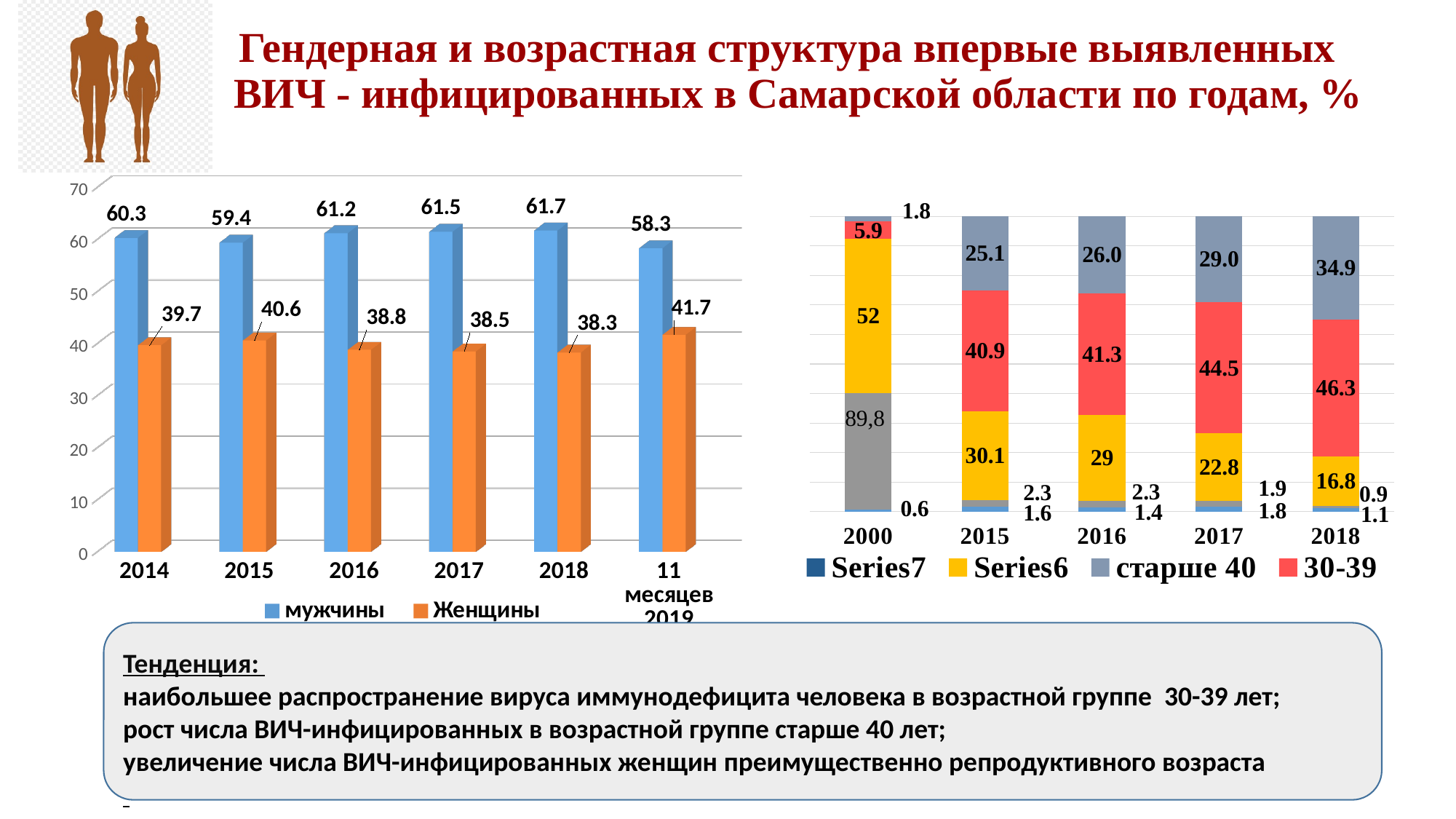
On the right chart, does the value for the 30-39 group rise or fall from 2015 to 2018? rise On the left chart, what is the value for Женщины in 2015? 40.6 On the right chart, what is the value for the 30-39 group in 2017? 44.5 On the left chart, in which category is the value for Женщины lowest? 2018 On the right chart, which is larger in 2016: the 30-39 group or the старше 40 group? 30-39 On the left chart, in which year is the value for мужчины highest? 2018 On the right chart, what is the value for the старше 40 group in 2018? 34.9 On the left chart, how many series does the legend list? 2 On the left chart, what is the value for мужчины in 2016? 61.2 On the left chart, what is the difference between мужчины and Женщины in 2014? 20.6 What kind of chart is the right chart? stacked bar chart On the left chart, how many categories are shown on the x axis? 6